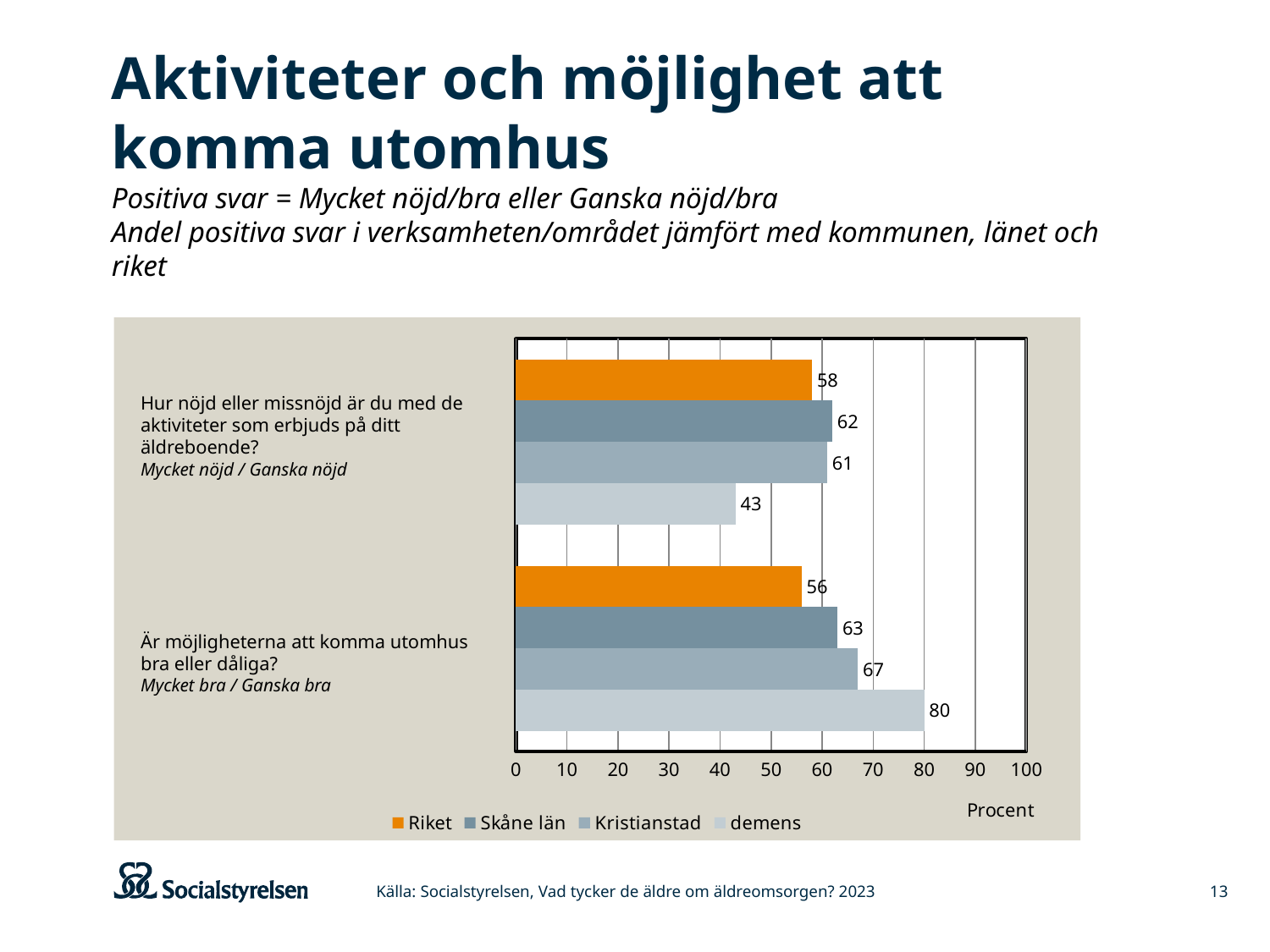
How many series does the legend list? 4 On the question about satisfaction with activities, which is larger: the value for Skåne län or the value for demens? Skåne län How many questions (categories) are shown on the chart? 2 What is the difference between the demens value and the Riket value on the question about opportunities to get outdoors? 24 Which series has the highest value on the question about opportunities to get outdoors? demens What is the value for demens on the question about opportunities to get outdoors? 80 What is the label of the x axis of the chart? Procent What is the value for demens on the question about satisfaction with activities offered at the care home? 43 What is the value for Kristianstad on the question about opportunities to get outdoors (Är möjligheterna att komma utomhus bra eller dåliga?)? 67 Which series has the lowest value on the question about satisfaction with activities offered at the care home? demens What is the value for Riket on the question about satisfaction with activities offered at the care home (Hur nöjd eller missnöjd är du med de aktiviteter som erbjuds på ditt äldreboende?)? 58 What kind of chart is shown on the slide? Bar chart